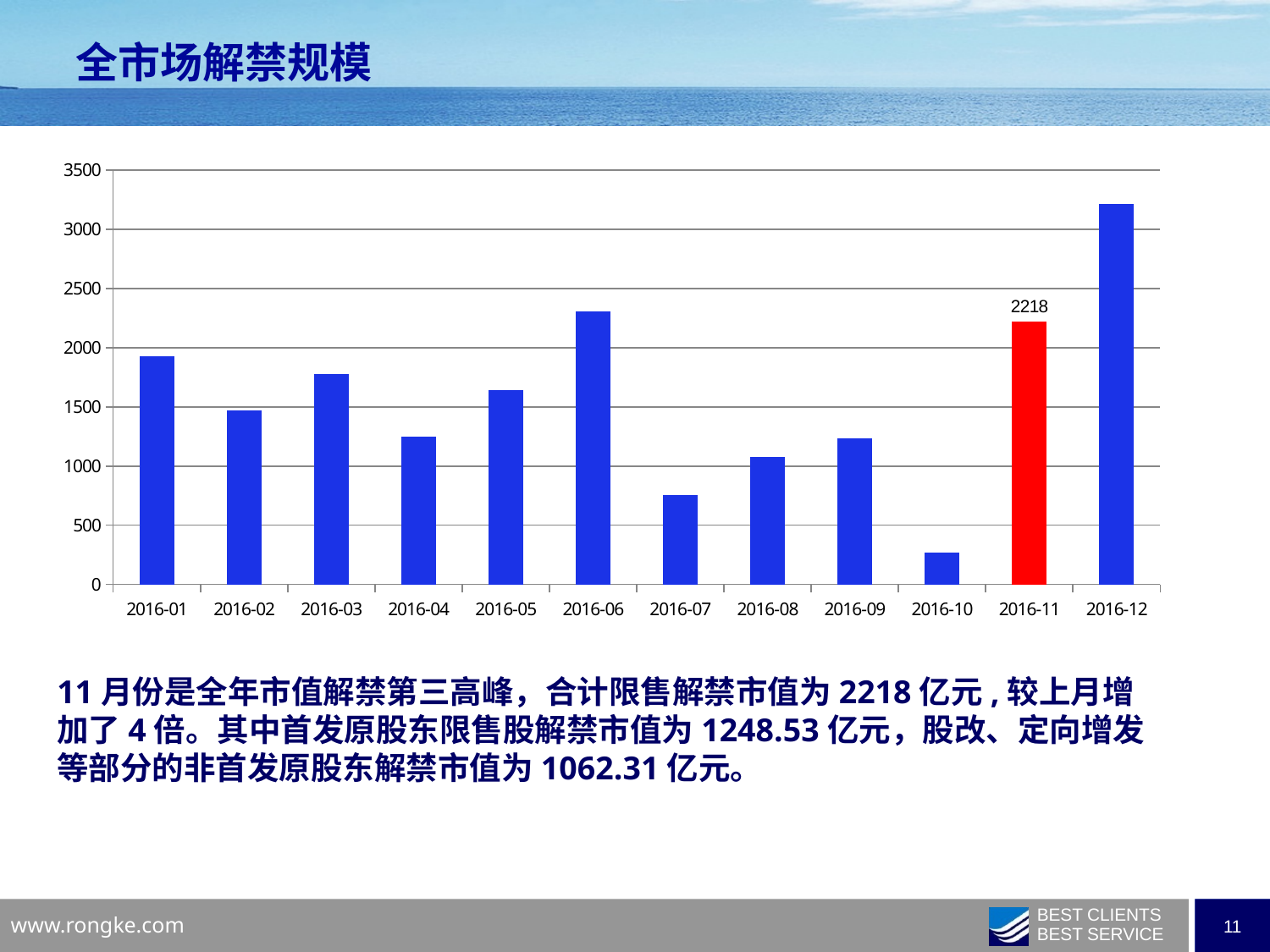
Which month has the highest bar? 2016-12 Which is larger, the value for 2016-06 or the value for 2016-07? 2016-06 Which is larger, the value for 2016-03 or the value for 2016-02? 2016-03 How many months are shown on the x axis? 12 Is the value for 2016-10 greater or less than 500? less Is the value for 2016-12 greater or less than 3000? greater What kind of chart is shown on the slide? bar chart Do the values rise or fall from 2016-07 to 2016-09? rise Which month has the lowest bar? 2016-10 What is the value shown for 2016-11? 2218 Is the value for 2016-07 greater or less than 500? greater Which month's bar is coloured red? 2016-11